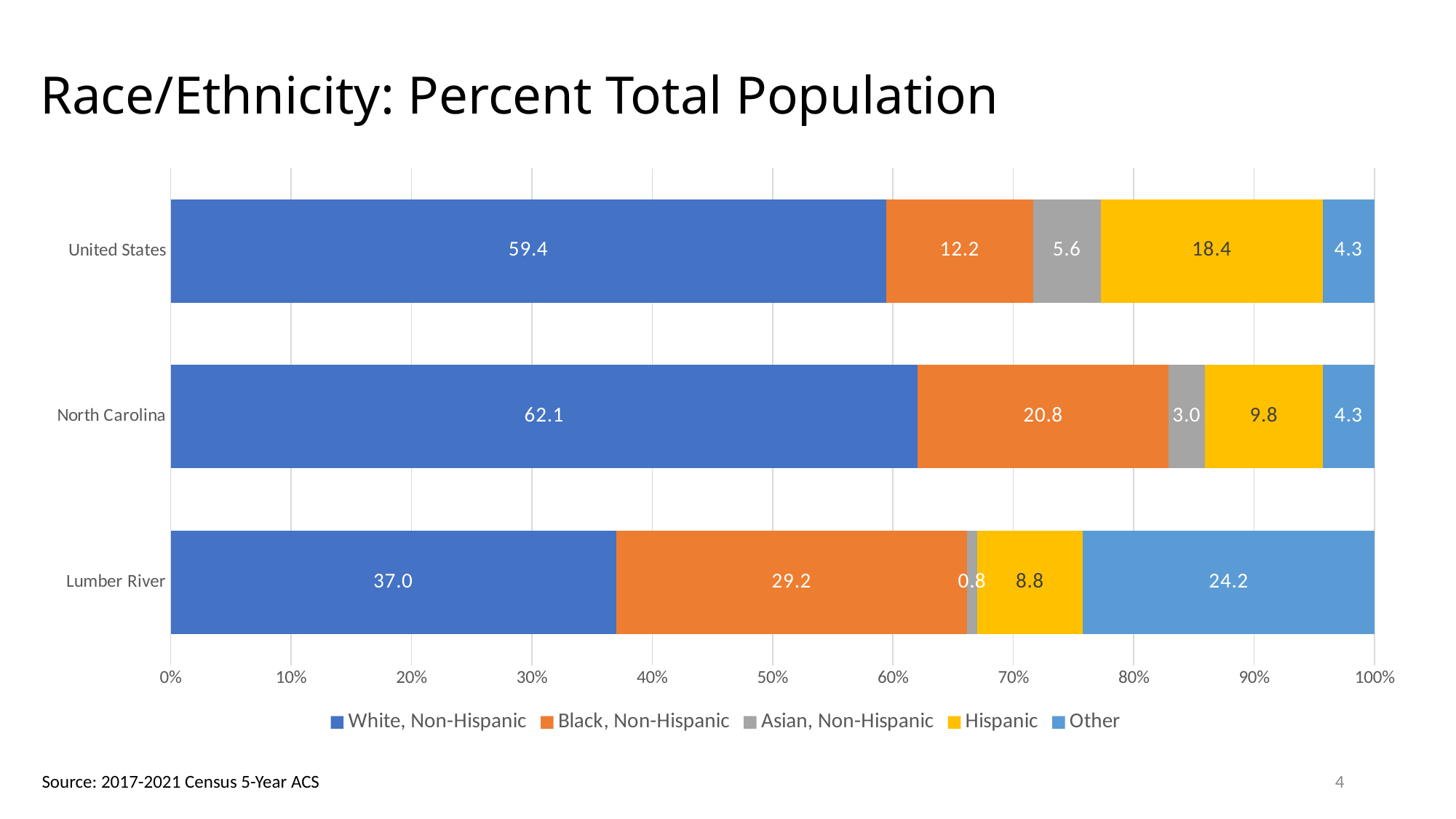
What is the value for Hispanic in the North Carolina bar? 9.8 Which is larger, the Hispanic value for the United States or for North Carolina? United States Which region has the lowest value for Asian, Non-Hispanic? Lumber River What is the value for White, Non-Hispanic in the United States bar? 59.4 Is the White, Non-Hispanic value for Lumber River greater or less than 40%? less Which region has the highest value for Other? Lumber River What is the value for Black, Non-Hispanic in the Lumber River bar? 29.2 How many series does the legend list? 5 What kind of chart is shown on the slide? Stacked bar chart What is the difference between the White, Non-Hispanic values for North Carolina and Lumber River? 25.1 What is the difference between the Black, Non-Hispanic values for North Carolina and the United States? 8.6 How many regions are shown on the chart? 3